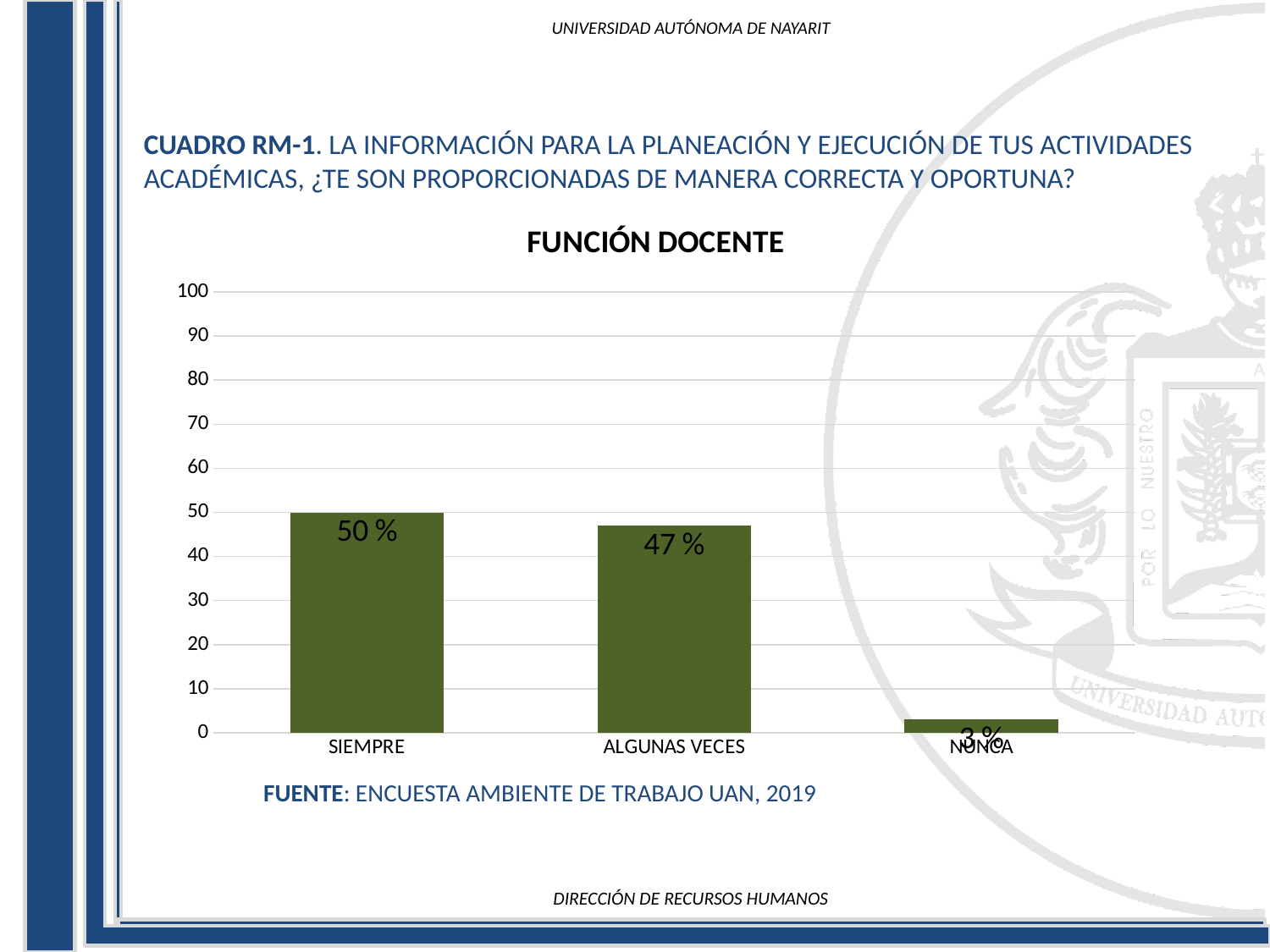
How many categories are shown on the x axis? 3 What is the value for NUNCA? 3 % What is the value for ALGUNAS VECES? 47 % Which is larger, the value for ALGUNAS VECES or the value for NUNCA? ALGUNAS VECES Which category has the highest value? SIEMPRE Is the value for ALGUNAS VECES greater or less than 50? less What is the difference between the values for SIEMPRE and ALGUNAS VECES? 3 % What is the title of the chart? FUNCIÓN DOCENTE What is the difference between the values for ALGUNAS VECES and NUNCA? 44 % What kind of chart is shown? bar chart Which category has the lowest value? NUNCA What is the value for SIEMPRE? 50 %